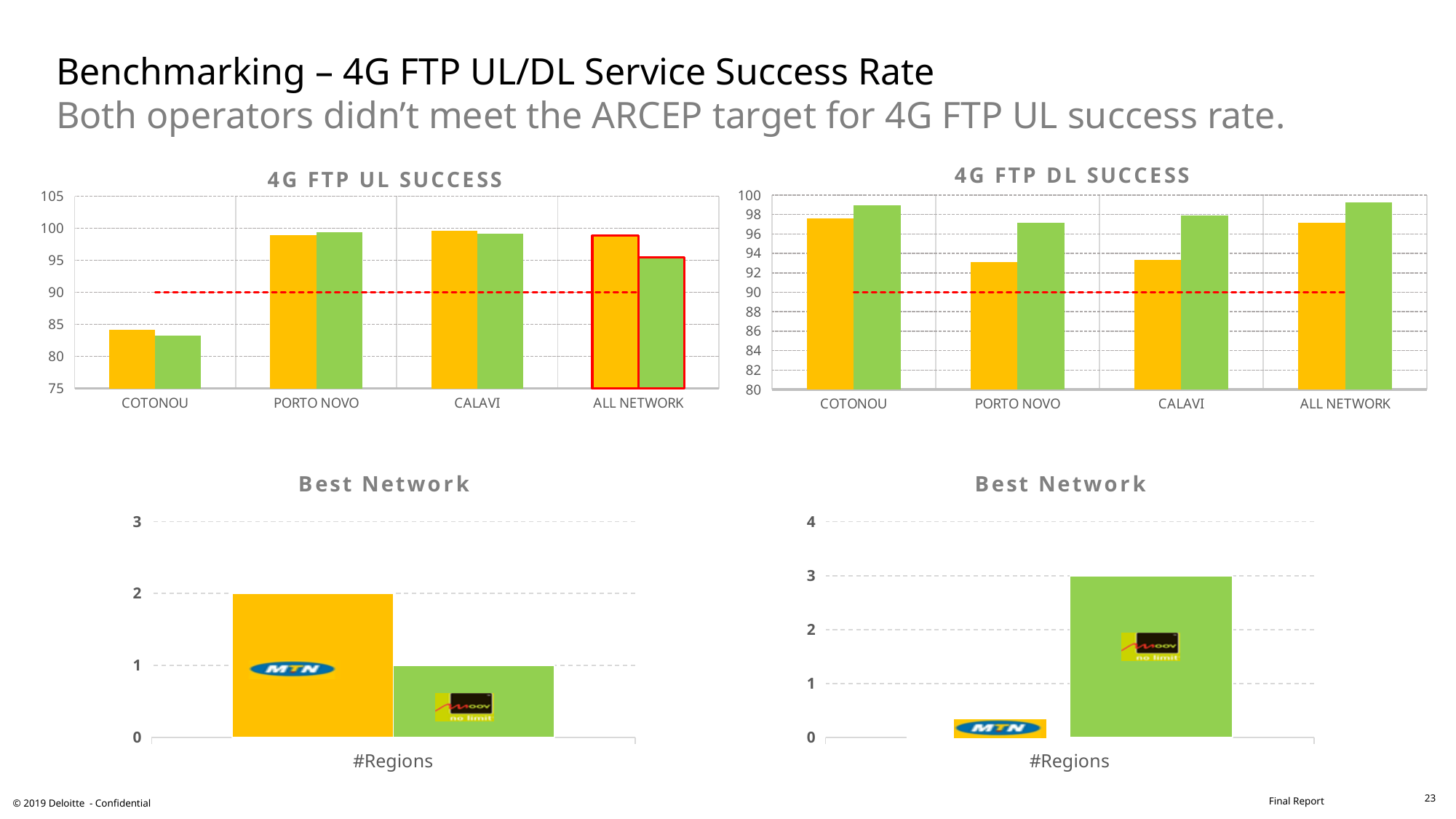
In the '4G FTP UL SUCCESS' chart, which category has the lowest orange bar? COTONOU In the bottom-right 'Best Network' chart, what is the value of the Moov bar? 3 In the '4G FTP DL SUCCESS' chart, is the orange bar for PORTO NOVO greater or less than 95? less In the '4G FTP UL SUCCESS' chart, for ALL NETWORK, which bar is taller, the orange one or the green one? the orange one How many categories are shown on the x axis of the '4G FTP UL SUCCESS' chart? 4 In the bottom-left 'Best Network' chart, what is the value of the MTN bar? 2 At what value on the y axis is the red dashed line drawn in the '4G FTP UL SUCCESS' chart? 90 What kind of chart is the '4G FTP UL SUCCESS' chart? bar chart In the bottom-left 'Best Network' chart, what is the value of the Moov bar? 1 In the '4G FTP UL SUCCESS' chart, is the green bar for PORTO NOVO greater or less than 95? greater In the '4G FTP UL SUCCESS' chart, is the orange bar for COTONOU greater or less than 90? less In the '4G FTP DL SUCCESS' chart, which orange bar is taller, COTONOU or PORTO NOVO? COTONOU